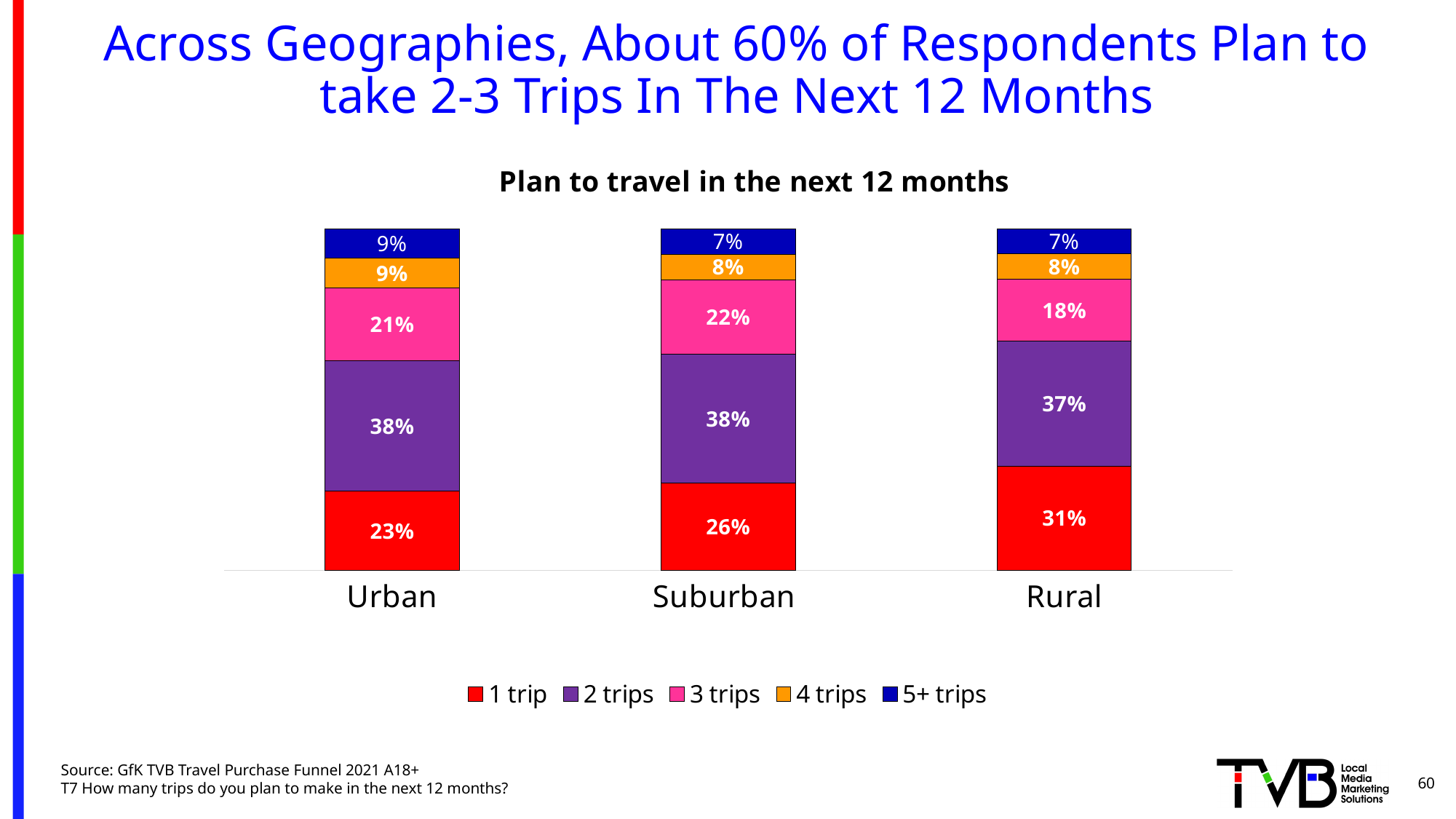
Which geography has the lowest share of respondents planning 3 trips? Rural What is the difference between the Rural and Urban percentages for 1 trip? 8% What is the title of the chart? Plan to travel in the next 12 months How many series does the legend list? 5 What kind of chart is shown on the slide? Stacked bar chart Is the 4 trips share larger for Urban or for Suburban? Urban How many geography categories are shown on the x axis? 3 Which geography has the highest share of respondents planning 1 trip? Rural What percentage of Urban respondents plan to take 1 trip? 23% What percentage of Suburban respondents plan to take 3 trips? 22% What percentage of Rural respondents plan to take 2 trips? 37% What percentage of Rural respondents plan to take 5+ trips? 7%